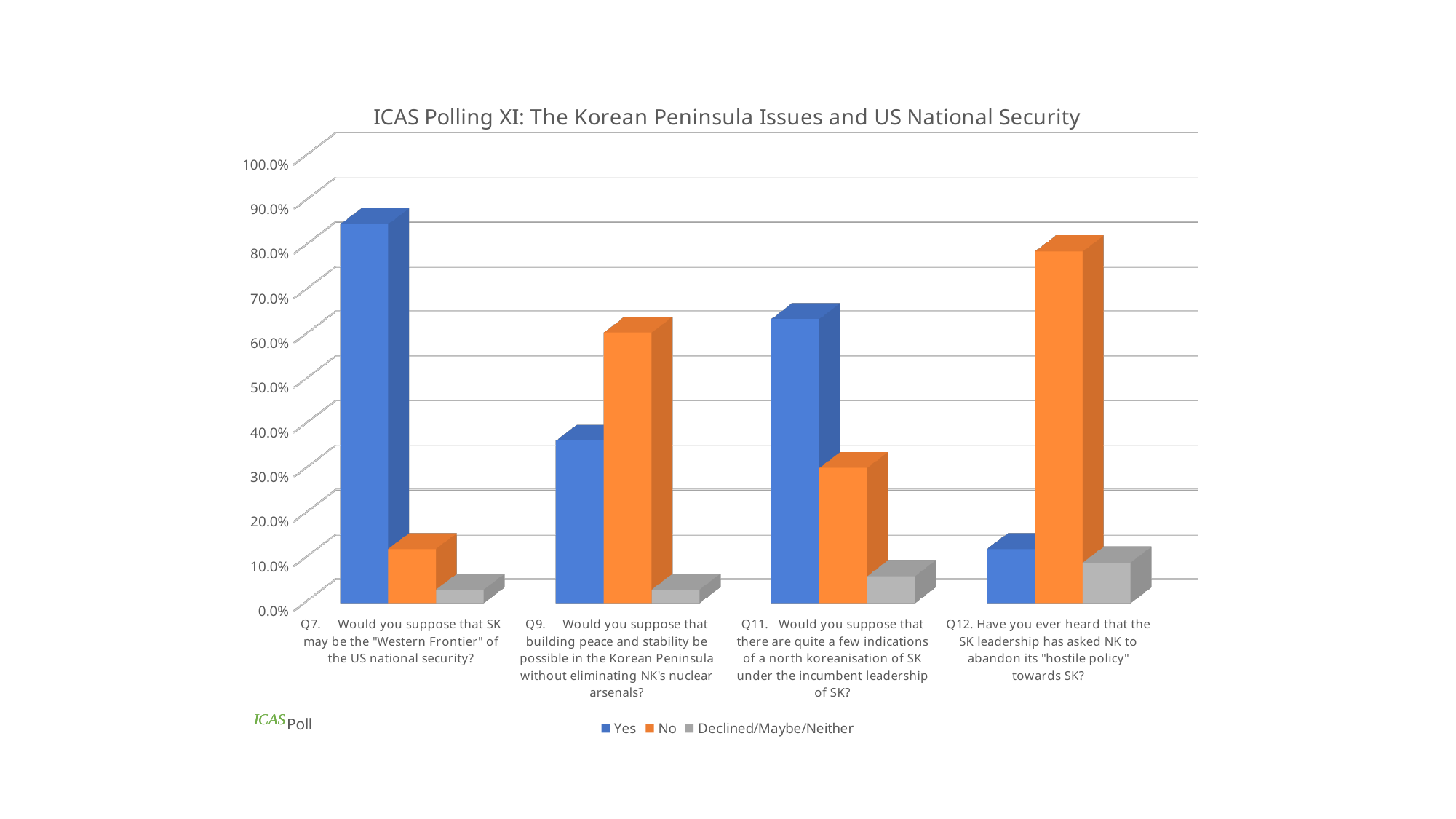
Which question has the highest "No" value? Q12 What kind of chart is shown on the slide? Bar chart Is the "No" value for Q9 greater or less than 50.0%? greater Which question has the highest "Yes" value? Q7 How many questions (categories) are shown along the x axis? 4 For Q11, which is larger, the "Yes" value or the "No" value? Yes How many series does the legend list? 3 Is the "Yes" value for Q7 greater or less than 70.0%? greater Which series is shown in orange according to the legend? No What is the title of the chart? ICAS Polling XI: The Korean Peninsula Issues and US National Security Which question has the lowest "Yes" value? Q12 For Q9, which is larger, the "Yes" value or the "No" value? No